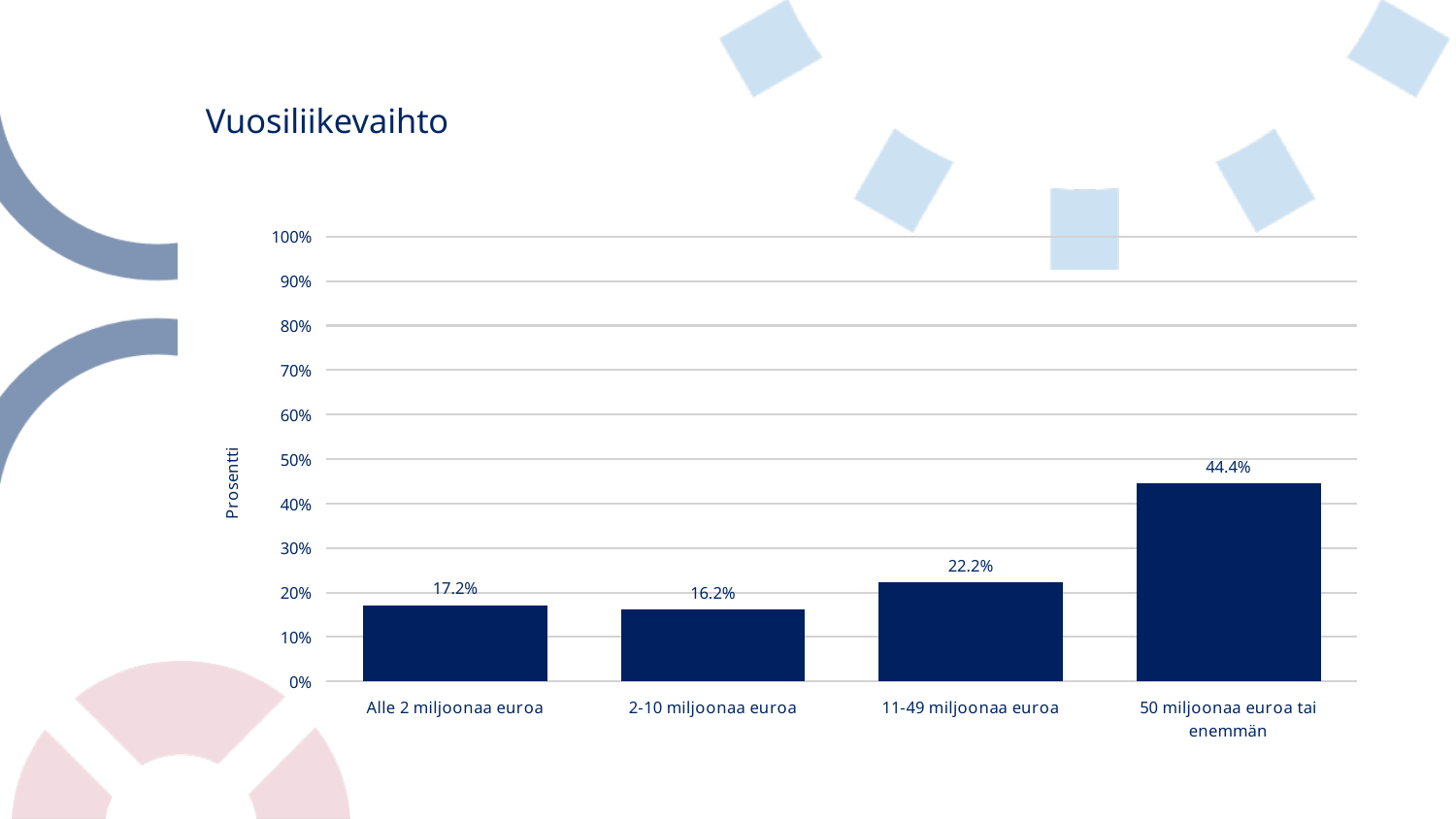
How many categories are shown on the x axis? 4 What is the title of the chart? Vuosiliikevaihto What is the value for "2-10 miljoonaa euroa"? 16.2% What is the value for "50 miljoonaa euroa tai enemmän"? 44.4% What is the value for "11-49 miljoonaa euroa"? 22.2% Is the value for "50 miljoonaa euroa tai enemmän" greater or less than 40%? greater What kind of chart is shown on the slide? bar chart Which category has the highest value? 50 miljoonaa euroa tai enemmän Which category has the lowest value? 2-10 miljoonaa euroa What is the difference between the values for "50 miljoonaa euroa tai enemmän" and "11-49 miljoonaa euroa"? 22.2% What is the value for "Alle 2 miljoonaa euroa"? 17.2% Which is larger, the value for "Alle 2 miljoonaa euroa" or "2-10 miljoonaa euroa"? Alle 2 miljoonaa euroa